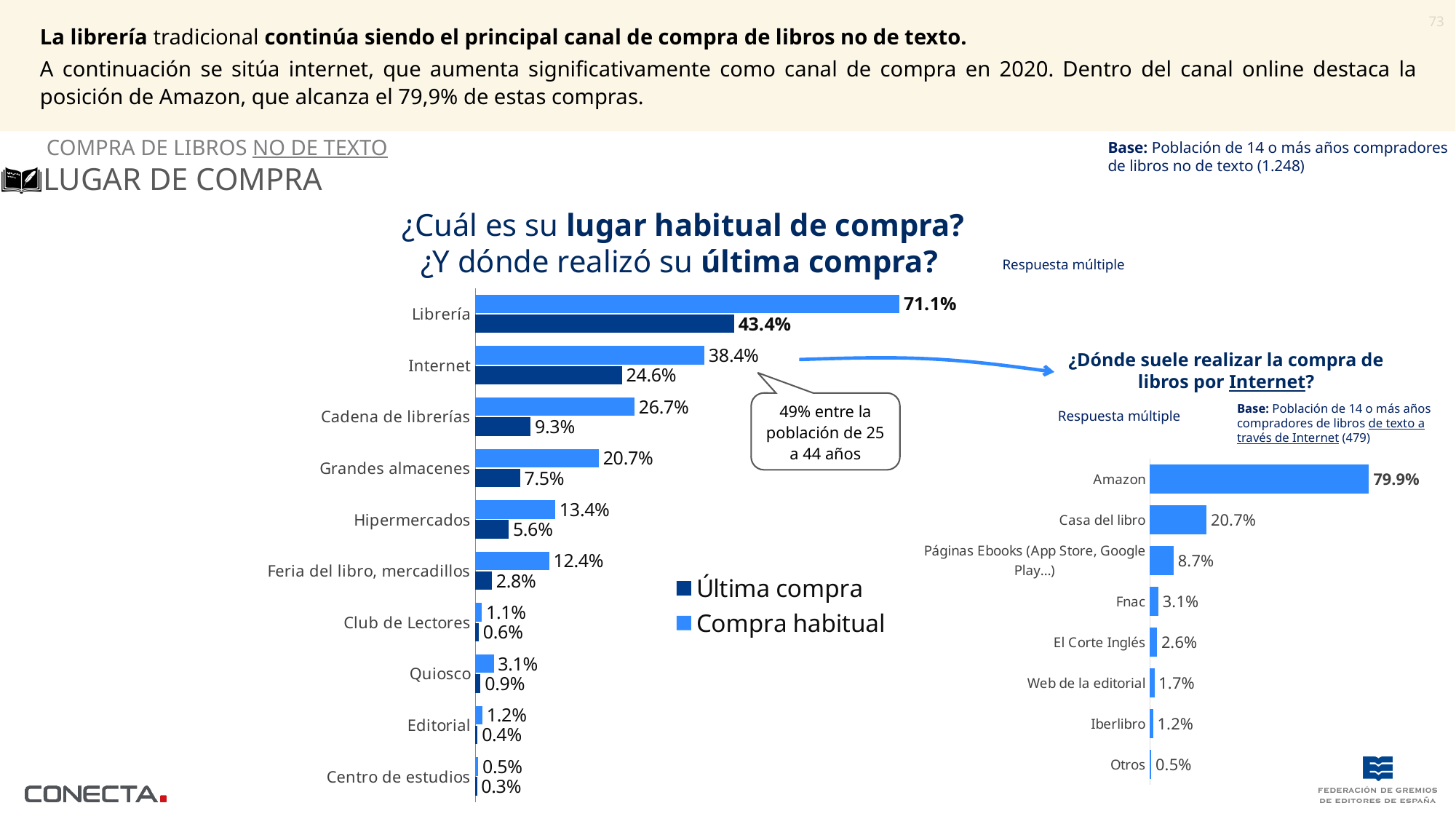
In the chart '¿Cuál es su lugar habitual de compra?', what is the 'Compra habitual' value for Librería? 71.1% In the chart '¿Cuál es su lugar habitual de compra?', what is the difference between the 'Compra habitual' and 'Última compra' values for Librería? 27.7% In the chart '¿Dónde suele realizar la compra de libros por Internet?', what is the value for Casa del libro? 20.7% In the chart '¿Dónde suele realizar la compra de libros por Internet?', what is the difference between the values for Amazon and Casa del libro? 59.2% In the chart '¿Cuál es su lugar habitual de compra?', what is the 'Última compra' value for Internet? 24.6% In the chart '¿Dónde suele realizar la compra de libros por Internet?', what is the value for Amazon? 79.9% In the chart '¿Cuál es su lugar habitual de compra?', how many series does the legend list? 2 In the chart '¿Cuál es su lugar habitual de compra?', which is larger: the 'Compra habitual' value for Cadena de librerías or for Grandes almacenes? Cadena de librerías In the chart '¿Cuál es su lugar habitual de compra?', how many categories are shown? 10 In the chart '¿Cuál es su lugar habitual de compra?', which category has the lowest 'Última compra' value? Centro de estudios What kind of chart is '¿Dónde suele realizar la compra de libros por Internet?'? Bar chart In the chart '¿Cuál es su lugar habitual de compra?', which category has the highest 'Compra habitual' value? Librería